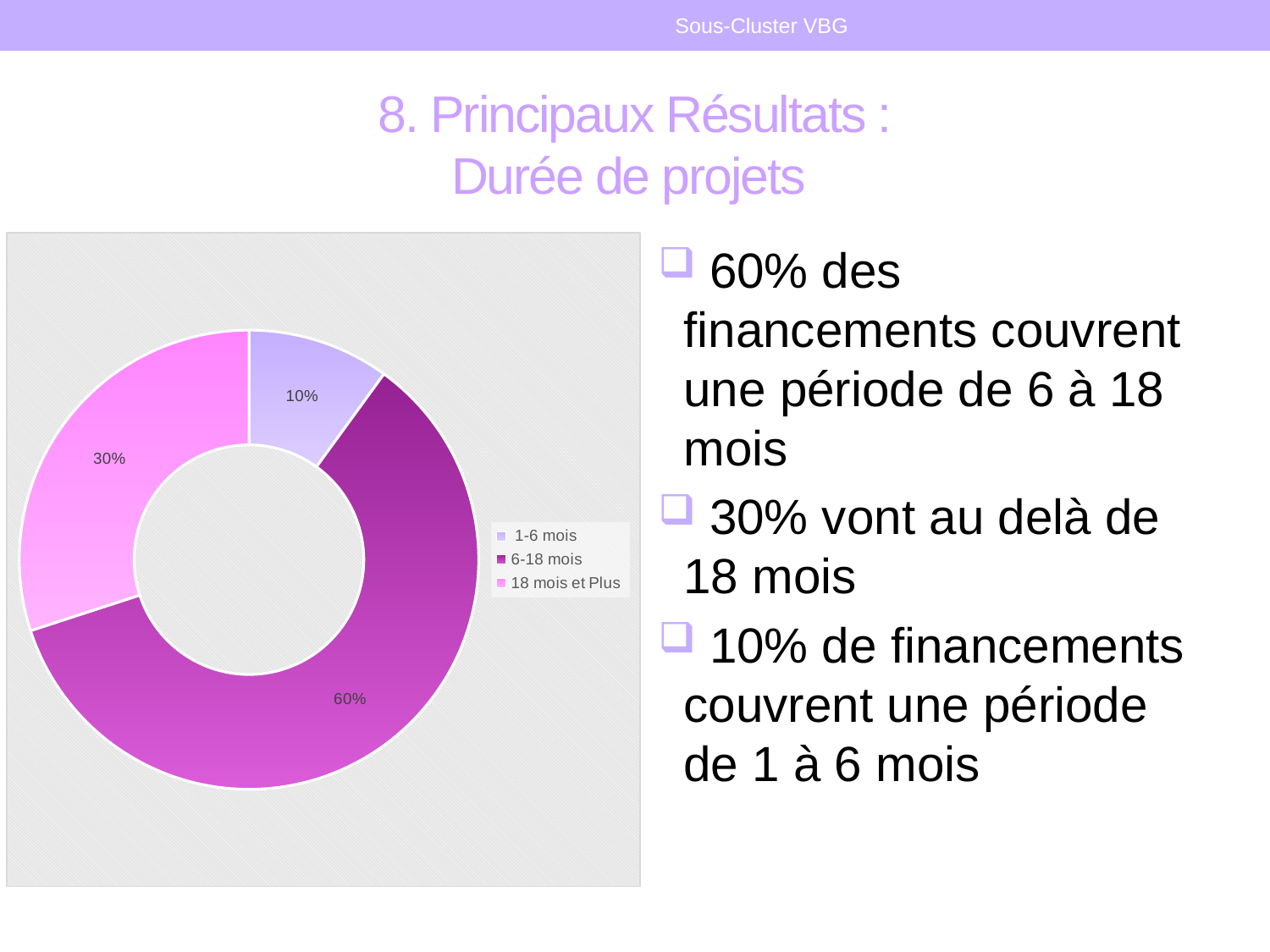
What share of the doughnut chart does the 1-6 mois slice represent? 10% What share of the doughnut chart does the 18 mois et Plus slice represent? 30% What is the difference in percentage points between the 6-18 mois slice and the 18 mois et Plus slice? 30 Which slice is larger, 1-6 mois or 18 mois et Plus? 18 mois et Plus Which legend entry is shown in the darkest purple colour? 6-18 mois How many categories are shown in the chart? 3 Which category has the largest slice in the chart? 6-18 mois What is the difference in percentage points between the 18 mois et Plus slice and the 1-6 mois slice? 20 What share of the doughnut chart does the 6-18 mois slice represent? 60% How many entries does the chart legend list? 3 What kind of chart is shown on the slide? Doughnut chart Which category has the smallest slice in the chart? 1-6 mois